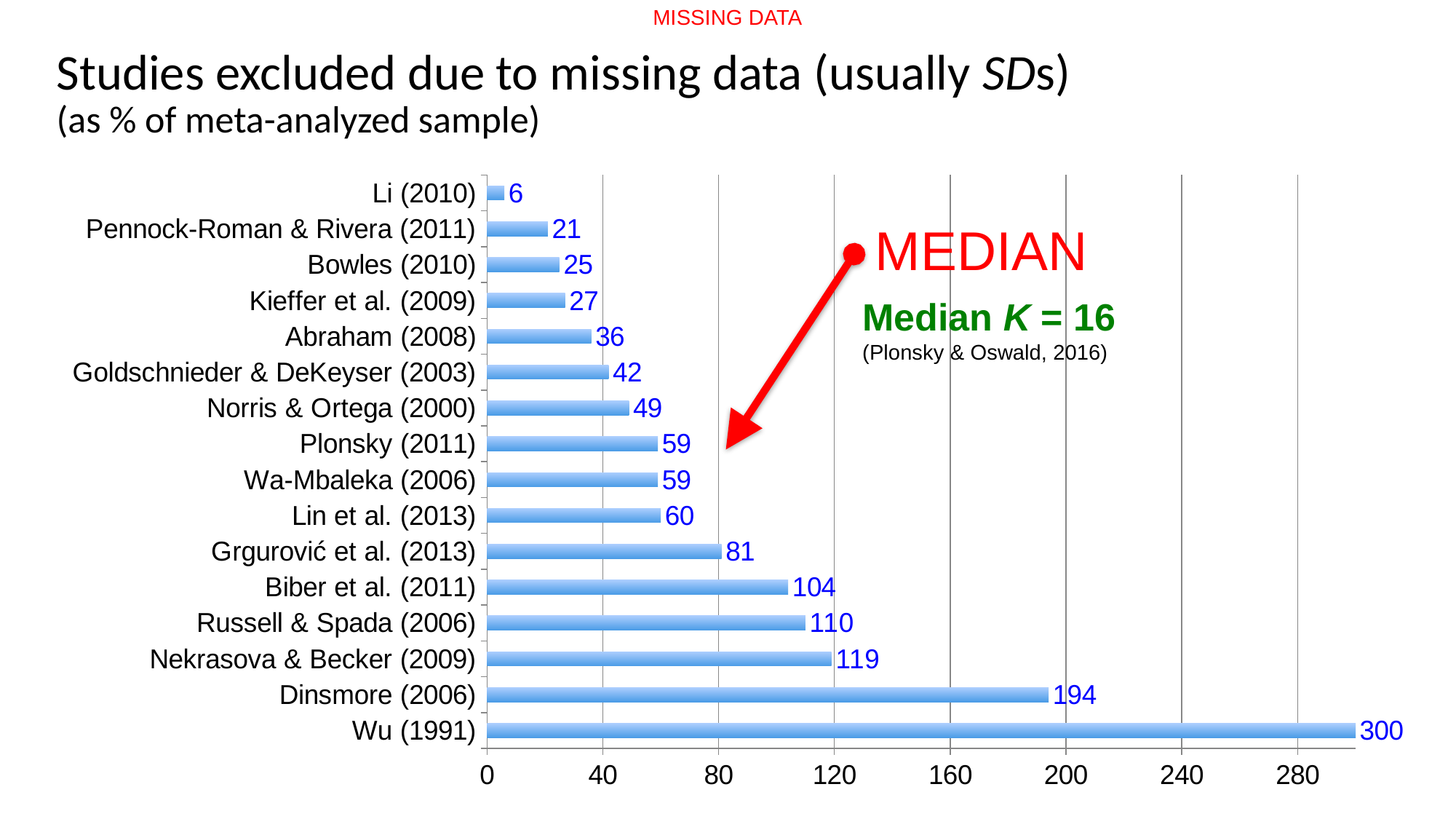
What is the difference between the values for Dinsmore (2006) and Nekrasova & Becker (2009)? 75 Which study is marked as the median by the red arrow? Plonsky (2011) Which study has the highest value? Wu (1991) What is the value for Abraham (2008)? 36 What is the value for Norris & Ortega (2000)? 49 Which study has the lowest value? Li (2010) What kind of chart is shown on the slide? bar chart Is the value for Russell & Spada (2006) greater or less than 80? greater Which is larger, the value for Grgurović et al. (2013) or the value for Lin et al. (2013)? Grgurović et al. (2013) What is the value for Wu (1991)? 300 How many studies are shown in the chart? 16 What is the value for Biber et al. (2011)? 104